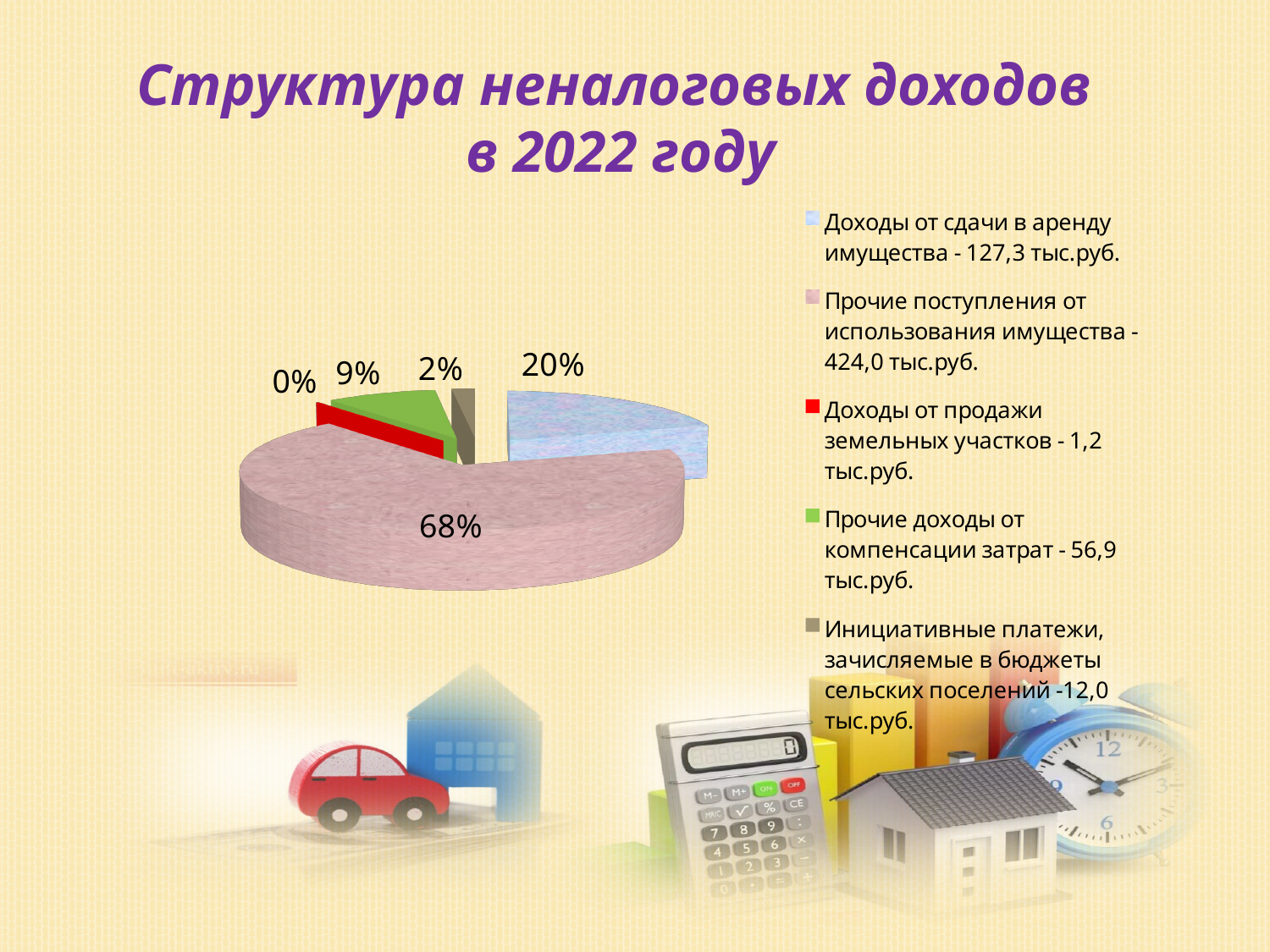
What share of the pie does "Инициативные платежи, зачисляемые в бюджеты сельских поселений" take? 2% What share of the pie does "Доходы от продажи земельных участков" take? 0% What share of the pie does "Доходы от сдачи в аренду имущества" take? 20% Which category has the largest share of the pie? Прочие поступления от использования имущества Which has the larger share: "Прочие доходы от компенсации затрат" or "Инициативные платежи, зачисляемые в бюджеты сельских поселений"? Прочие доходы от компенсации затрат What kind of chart is shown on the slide? Pie chart Which category has the smallest share of the pie? Доходы от продажи земельных участков How many categories does the legend of the pie chart list? 5 What is the title of the chart on the slide? Структура неналоговых доходов в 2022 году What is the difference in percentage points between the shares of "Прочие поступления от использования имущества" and "Доходы от сдачи в аренду имущества"? 48 percentage points